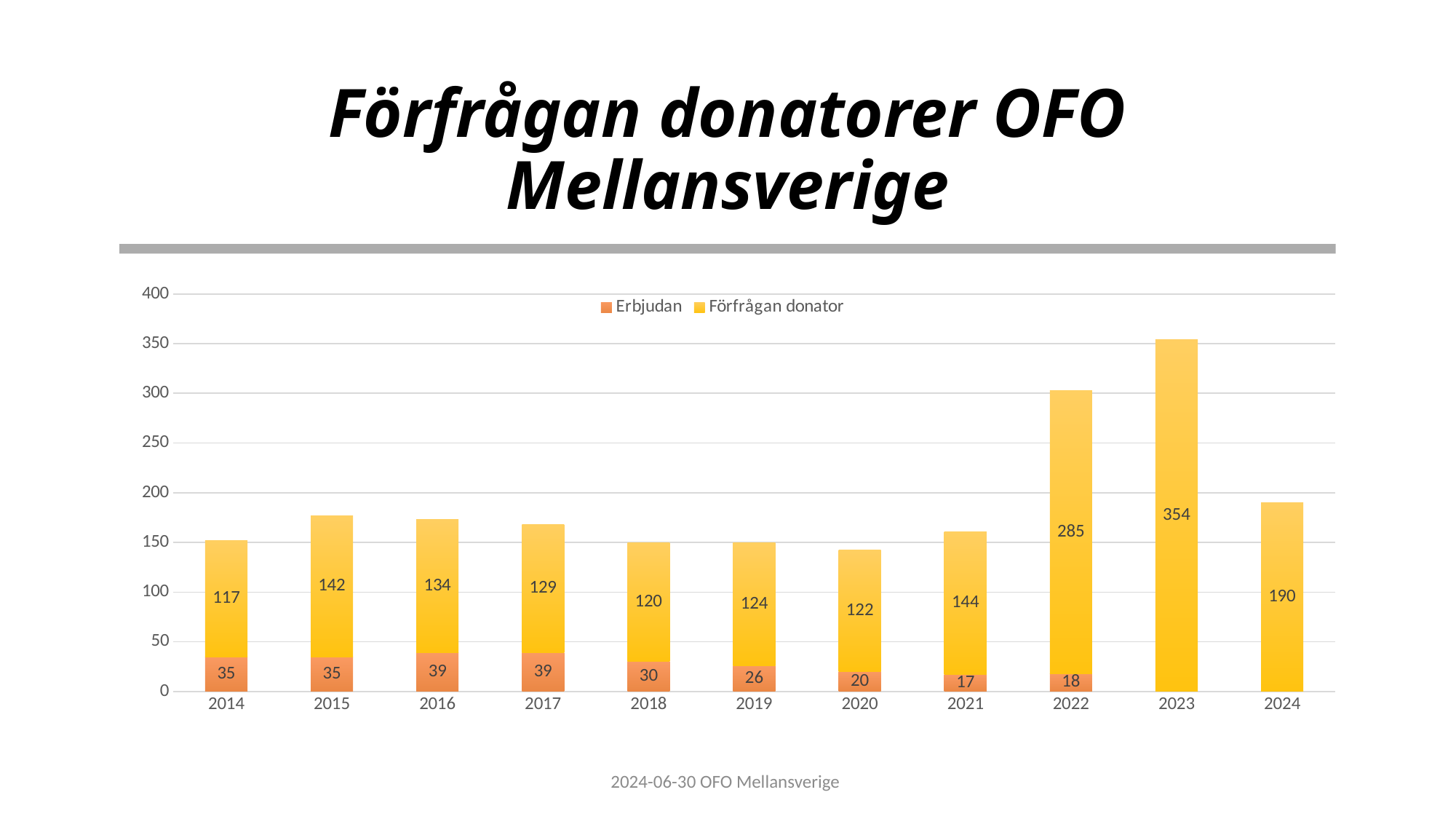
What is the difference between the Förfrågan donator values for 2023 and 2022? 69 How many years are shown on the x axis? 11 Which year has the highest Förfrågan donator value? 2023 What is the total of the stacked bar for 2014? 152 What kind of chart is shown on the slide? Stacked bar chart How many series does the legend list? 2 What is the value of Erbjudan for 2016? 39 What is the value of Förfrågan donator for 2022? 285 Which is larger, the Förfrågan donator value for 2015 or for 2017? 2015 Which year has the lowest Erbjudan value among the years with an Erbjudan label? 2021 What is the title of the slide? Förfrågan donatorer OFO Mellansverige Is the total height of the 2022 bar greater or less than 300? greater